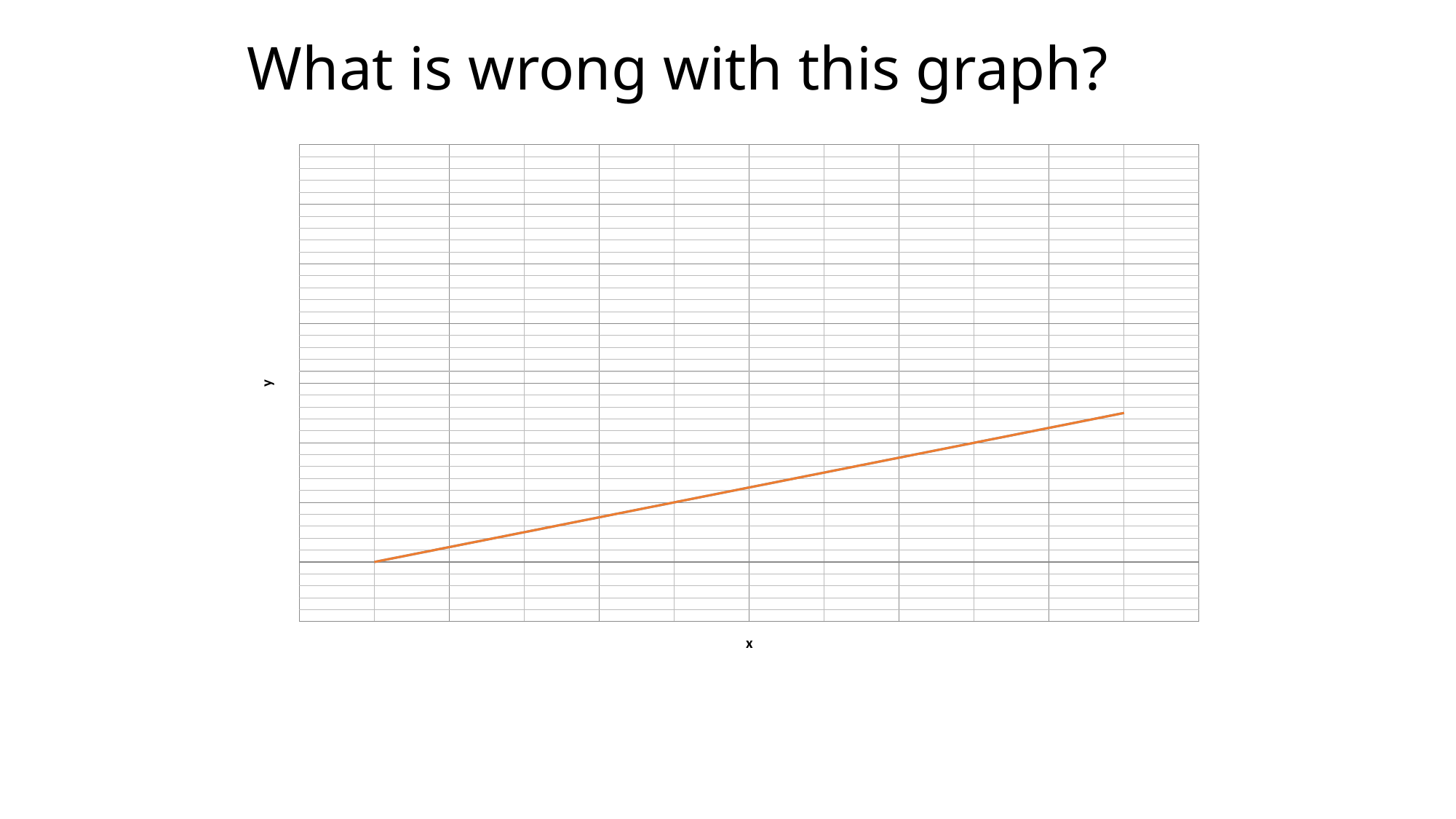
Do the values of the plotted line rise or fall as x increases? rise What is the label on the vertical axis of the chart? y What kind of chart is shown on the slide? line chart What is the label on the horizontal axis of the chart? x